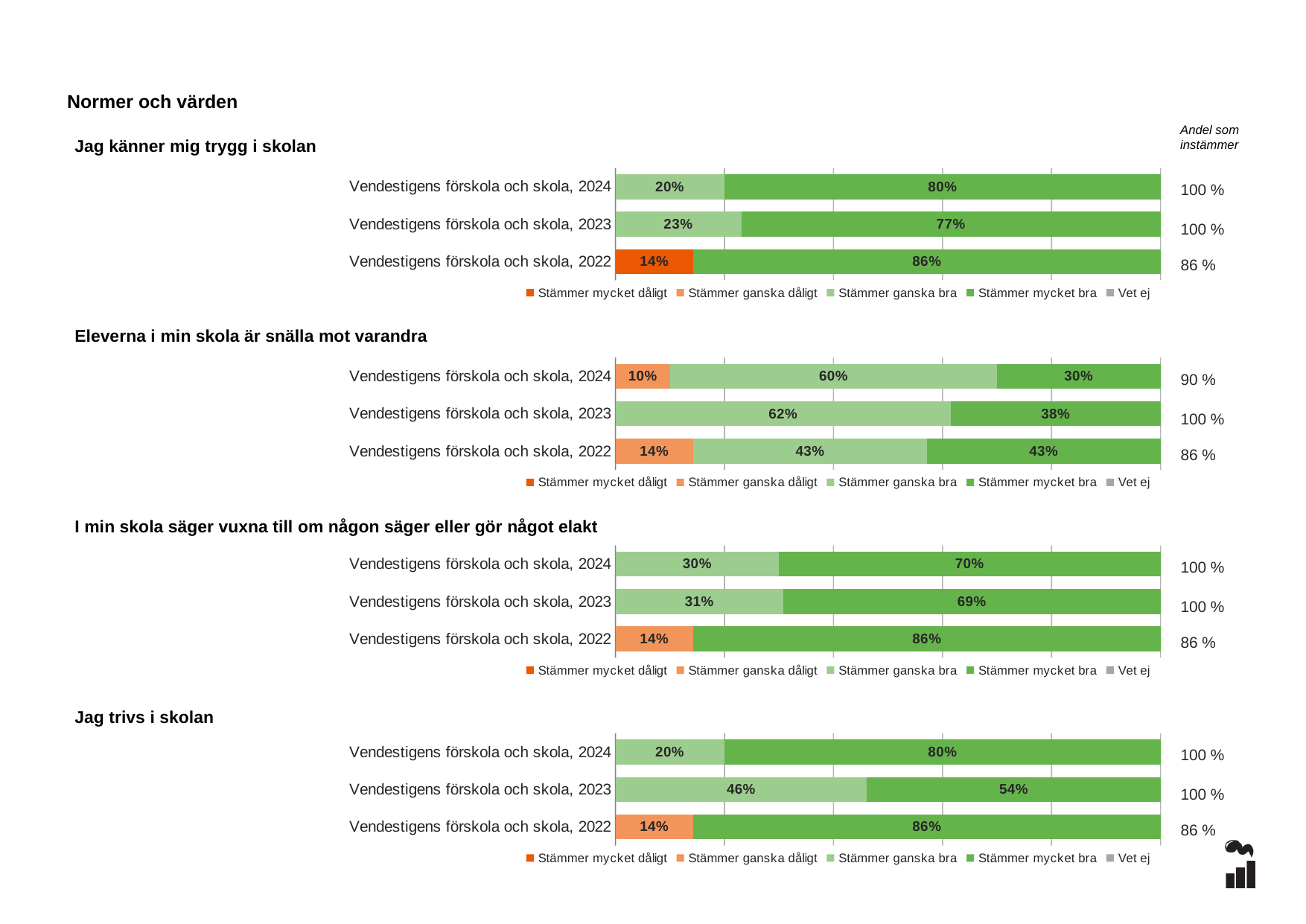
In the chart 'Eleverna i min skola är snälla mot varandra', what is the 'Stämmer ganska dåligt' value for Vendestigens förskola och skola, 2024? 10% In the chart 'I min skola säger vuxna till om någon säger eller gör något elakt', is the 'Stämmer mycket bra' value larger for 2024 or 2022? 2022 In the chart 'Jag känner mig trygg i skolan', what is the 'Stämmer mycket bra' value for Vendestigens förskola och skola, 2024? 80% In the chart 'Jag trivs i skolan', what is the difference between the 'Stämmer mycket bra' values for 2024 and 2023? 26% In the chart 'Jag trivs i skolan', what is the 'Stämmer ganska bra' value for Vendestigens förskola och skola, 2023? 46% How many series does the legend of the chart 'Jag trivs i skolan' list? 5 What kind of chart is 'Jag känner mig trygg i skolan'? Stacked bar chart In the chart 'Eleverna i min skola är snälla mot varandra', which year has the highest 'Stämmer mycket bra' value? Vendestigens förskola och skola, 2022 In the chart 'Jag känner mig trygg i skolan', what is the 'Stämmer ganska bra' value for Vendestigens förskola och skola, 2023? 23% In the chart 'Eleverna i min skola är snälla mot varandra', what is the 'Andel som instämmer' for Vendestigens förskola och skola, 2024? 90 % In the chart 'Eleverna i min skola är snälla mot varandra', what is the difference between the 'Stämmer ganska bra' values for 2023 and 2024? 2% In the chart 'I min skola säger vuxna till om någon säger eller gör något elakt', what is the 'Stämmer mycket bra' value for Vendestigens förskola och skola, 2023? 69%